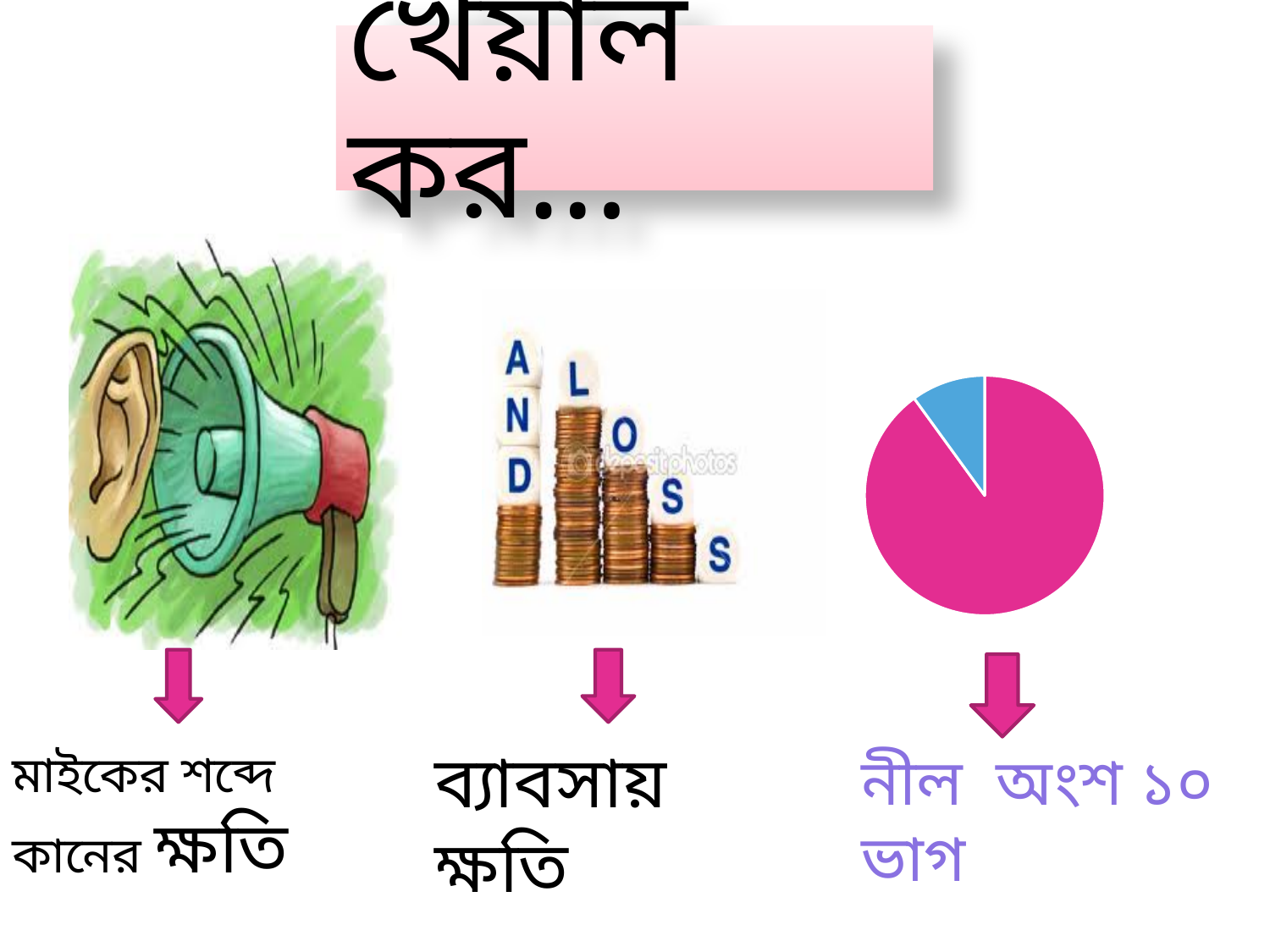
Does the pie chart on the slide have a legend? No Which colour slice is the smallest in the pie chart? blue What does the caption under the pie chart say? নীল অংশ ১০ ভাগ In the pie chart, which slice is larger, the pink one or the blue one? the pink one Which colour slice is the largest in the pie chart? pink How many slices does the pie chart on the right have? 2 What kind of chart is shown on the right side of the slide? pie chart According to the caption below the pie chart, what share does the blue portion represent? ১০ ভাগ